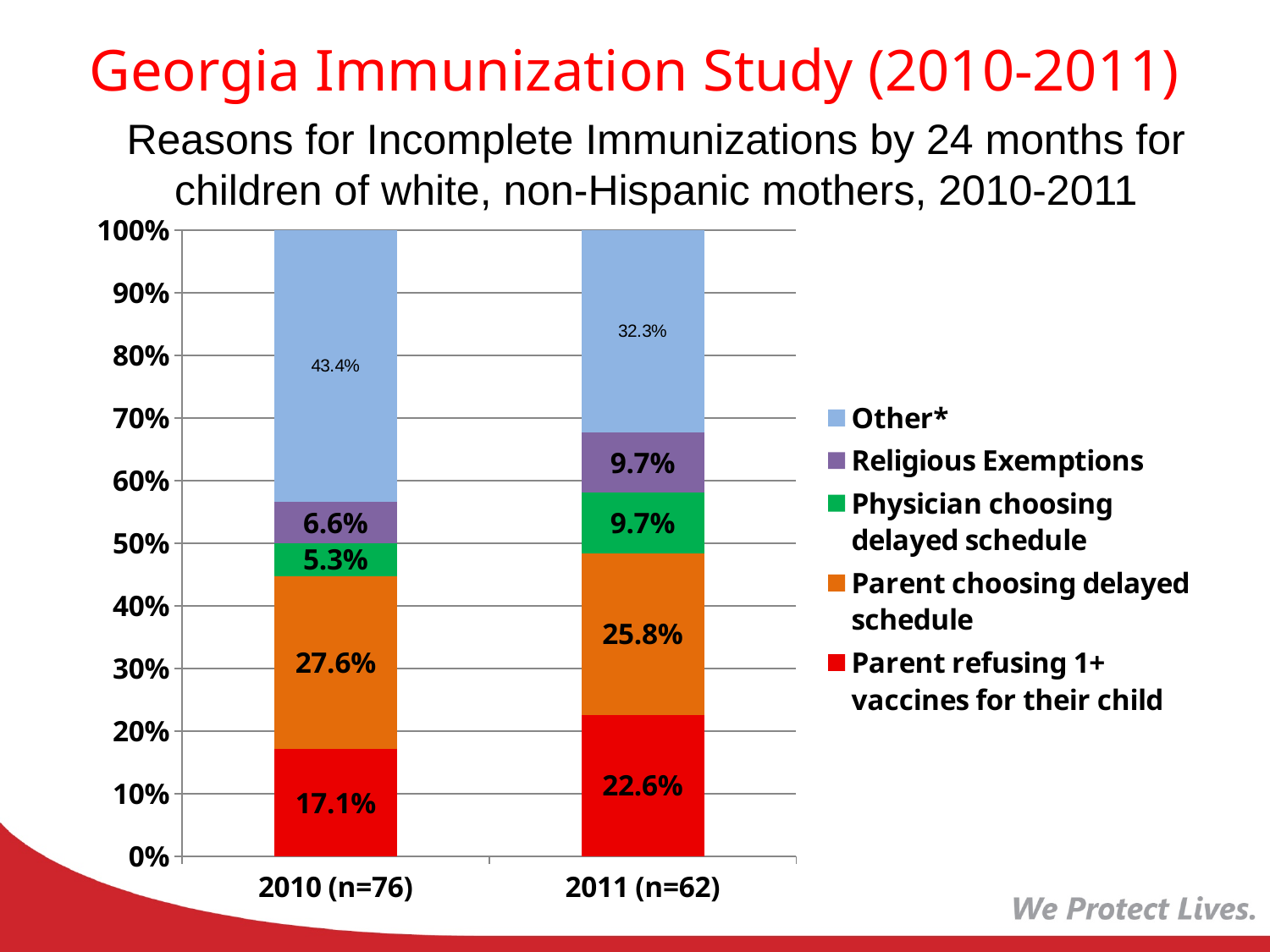
What percentage of the 2010 (n=76) bar is attributed to Parent refusing 1+ vaccines for their child? 17.1% How many series does the legend list? 5 Which reason has the largest share in the 2010 (n=76) bar? Other* Does the share for Parent refusing 1+ vaccines for their child rise or fall from 2010 to 2011? Rise What is the value for Other* in the 2011 (n=62) bar? 32.3% How many bars are plotted in the chart? 2 Is the share for Parent choosing delayed schedule larger in 2010 (n=76) or in 2011 (n=62)? 2010 (n=76) What kind of chart is shown on the slide? Stacked bar chart What is the value for Religious Exemptions in 2010 (n=76)? 6.6% What is the value for Physician choosing delayed schedule in 2011 (n=62)? 9.7% Which reason has the smallest share in the 2010 (n=76) bar? Physician choosing delayed schedule By how many percentage points did the Other* share fall from 2010 (n=76) to 2011 (n=62)? 11.1 percentage points